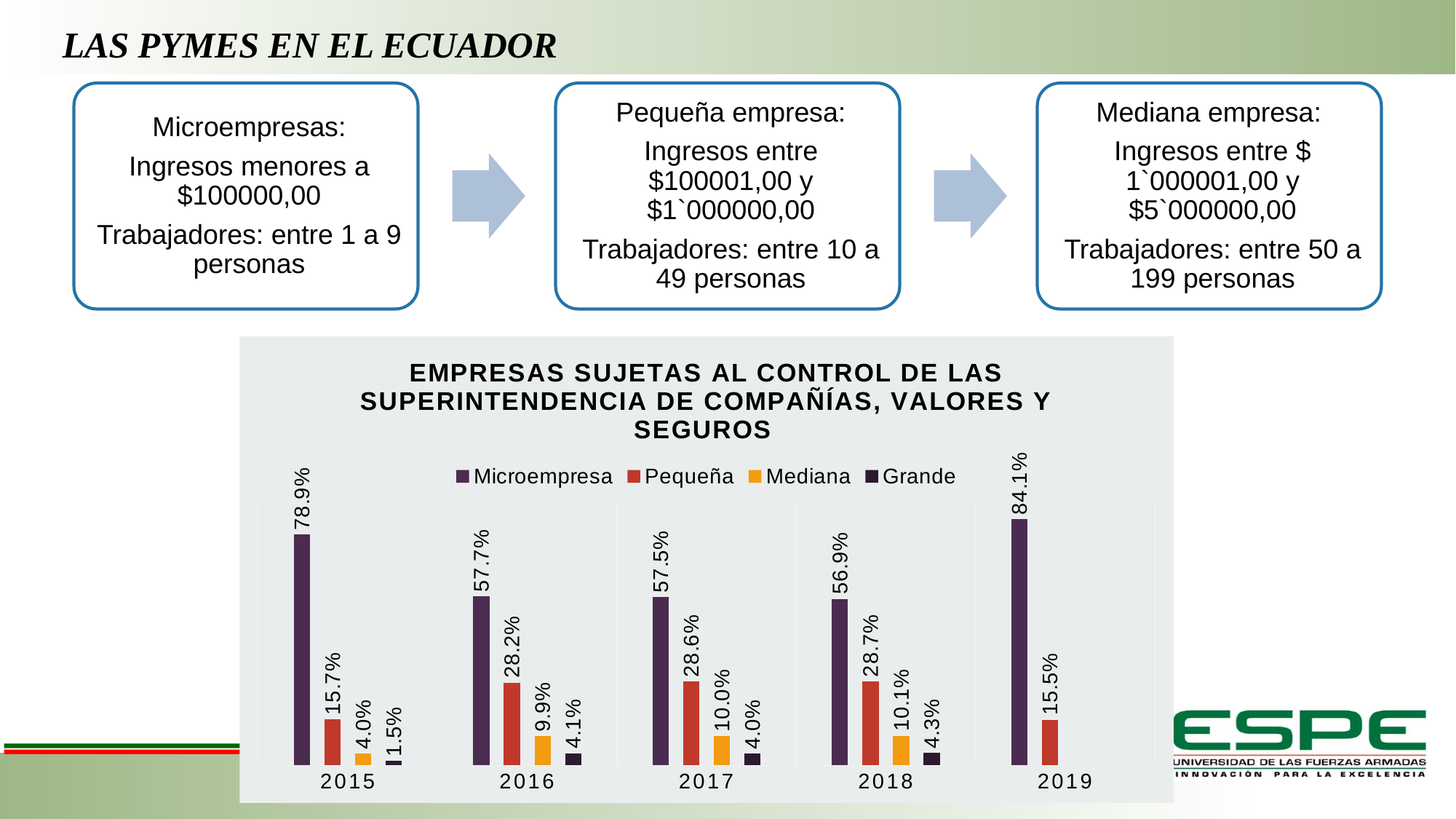
What is the value for Mediana in 2018? 10.1% What kind of chart is shown on the slide? Bar chart What is the value for Grande in 2016? 4.1% In which year is the Microempresa value highest? 2019 What is the difference between the Microempresa values in 2019 and 2015? 5.2% How many series does the legend list? 4 Which is larger, the Pequeña value in 2016 or in 2018? 2018 How many years are shown on the x axis? 5 What is the value for Pequeña in 2017? 28.6% What is the value for Microempresa in 2015? 78.9% In which year is the Grande value lowest? 2015 Which series is shown in orange in the legend? Mediana